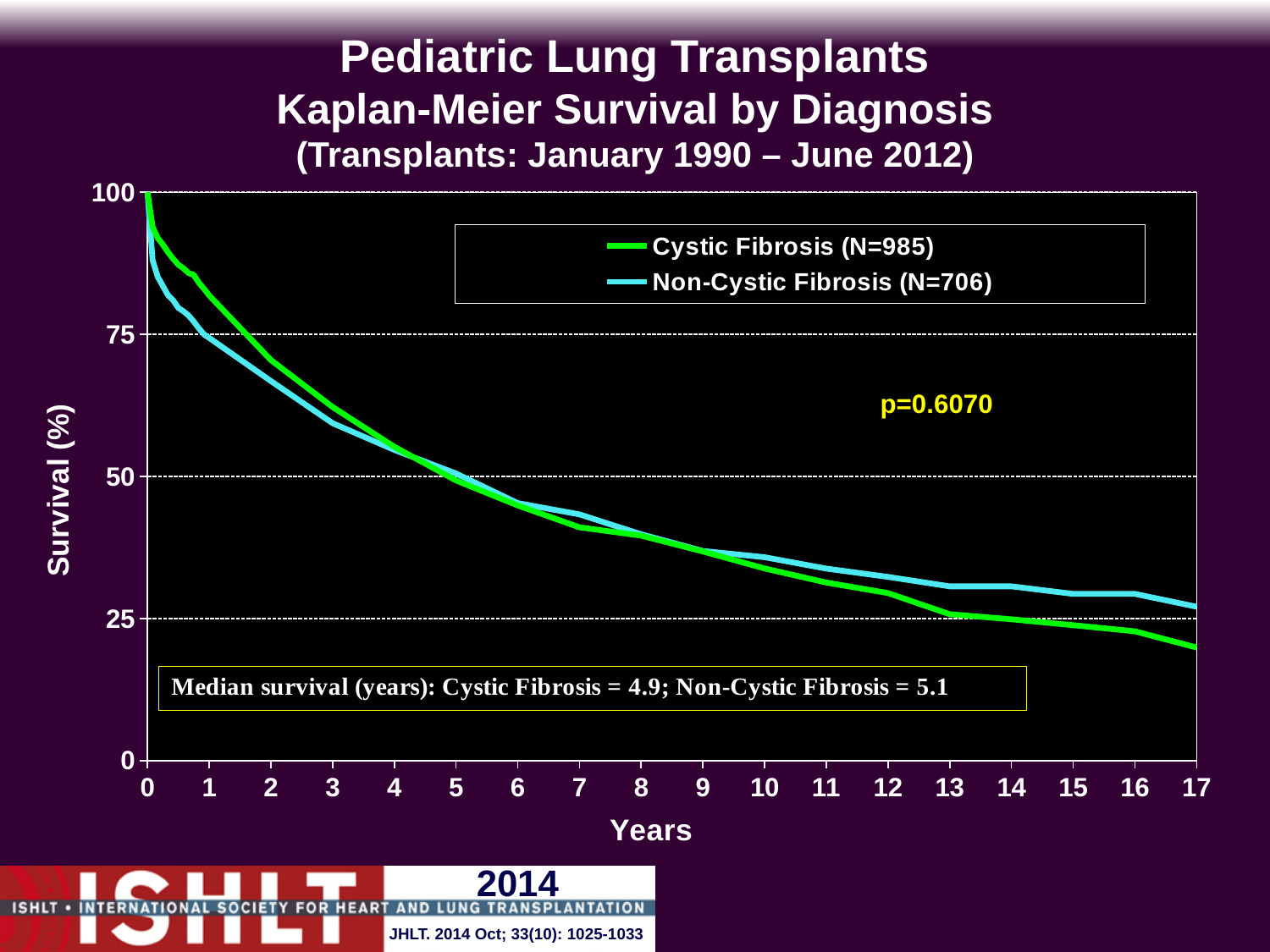
Is the survival value for Cystic Fibrosis at 1 year greater or less than 75? greater What is the median survival in years for Non-Cystic Fibrosis? 5.1 What p-value is shown on the chart? p=0.6070 What kind of chart is shown on the slide? line chart At 13 years, which series has the higher survival, Cystic Fibrosis or Non-Cystic Fibrosis? Non-Cystic Fibrosis What is the N for the Cystic Fibrosis group in the legend? 985 Is the survival value for Cystic Fibrosis at 17 years greater or less than 25? less What is the N for the Non-Cystic Fibrosis group in the legend? 706 Do the survival curves rise or fall as years increase? fall Is the survival value for Non-Cystic Fibrosis at 17 years greater or less than 25? greater How many series does the legend list? 2 What is the median survival in years for Cystic Fibrosis? 4.9